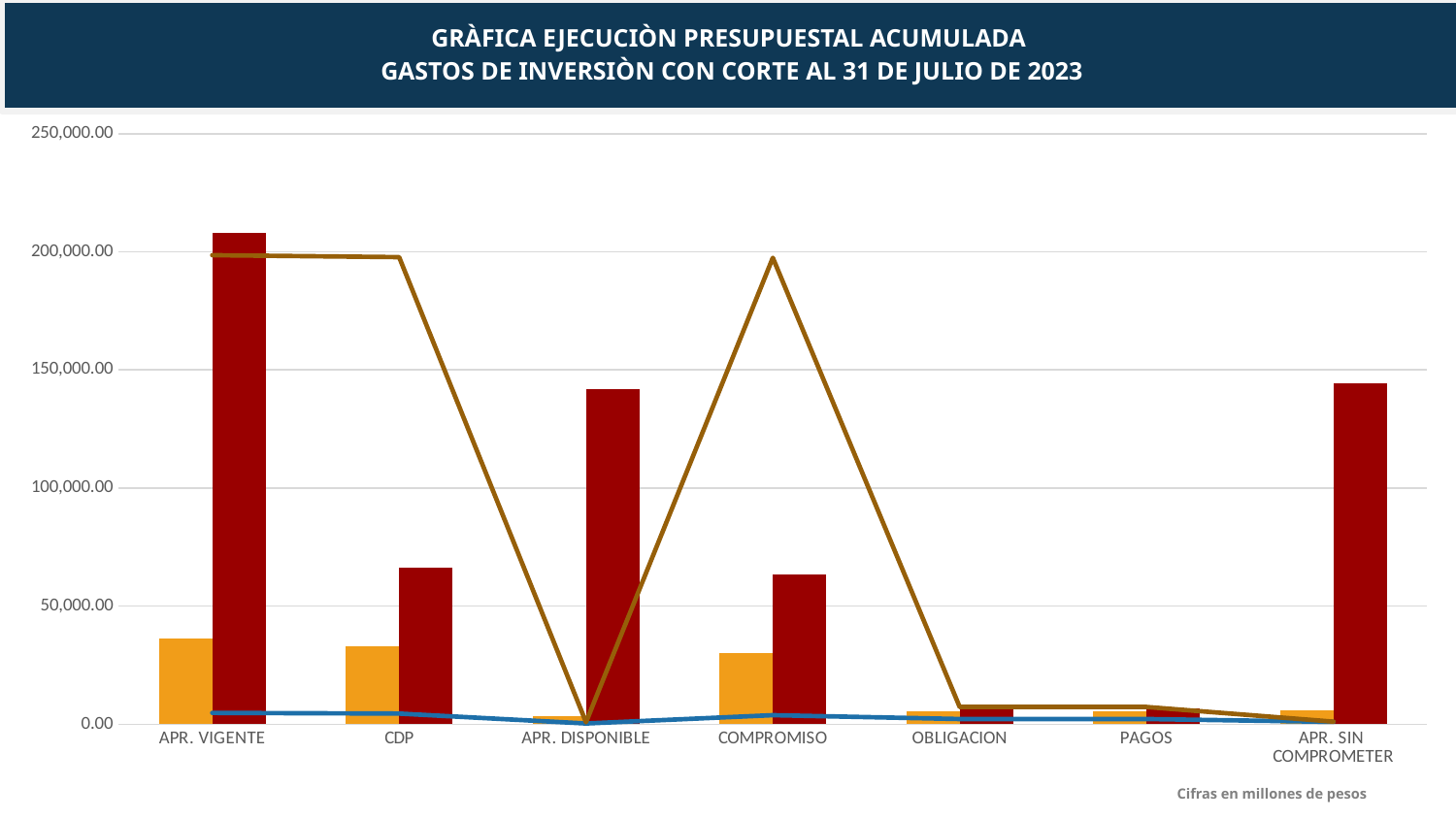
Is the dark red bar for APR. VIGENTE greater or less than 200,000.00? greater How many categories are shown along the x axis? 7 Does the brown line rise or fall between APR. DISPONIBLE and COMPROMISO? rise Is the dark red bar for APR. DISPONIBLE greater or less than 150,000.00? less What kind of chart is shown on the slide? A combined bar and line chart Which category has the tallest dark red bar? APR. VIGENTE According to the note below the chart, in what units are the figures expressed? Millones de pesos Which category has the tallest orange bar? APR. VIGENTE Which is larger, the dark red bar for APR. VIGENTE or the dark red bar for APR. SIN COMPROMETER? APR. VIGENTE Does the brown line rise or fall between CDP and APR. DISPONIBLE? fall Is the orange bar for APR. VIGENTE greater or less than 50,000.00? less How many bars are plotted for each category? 2